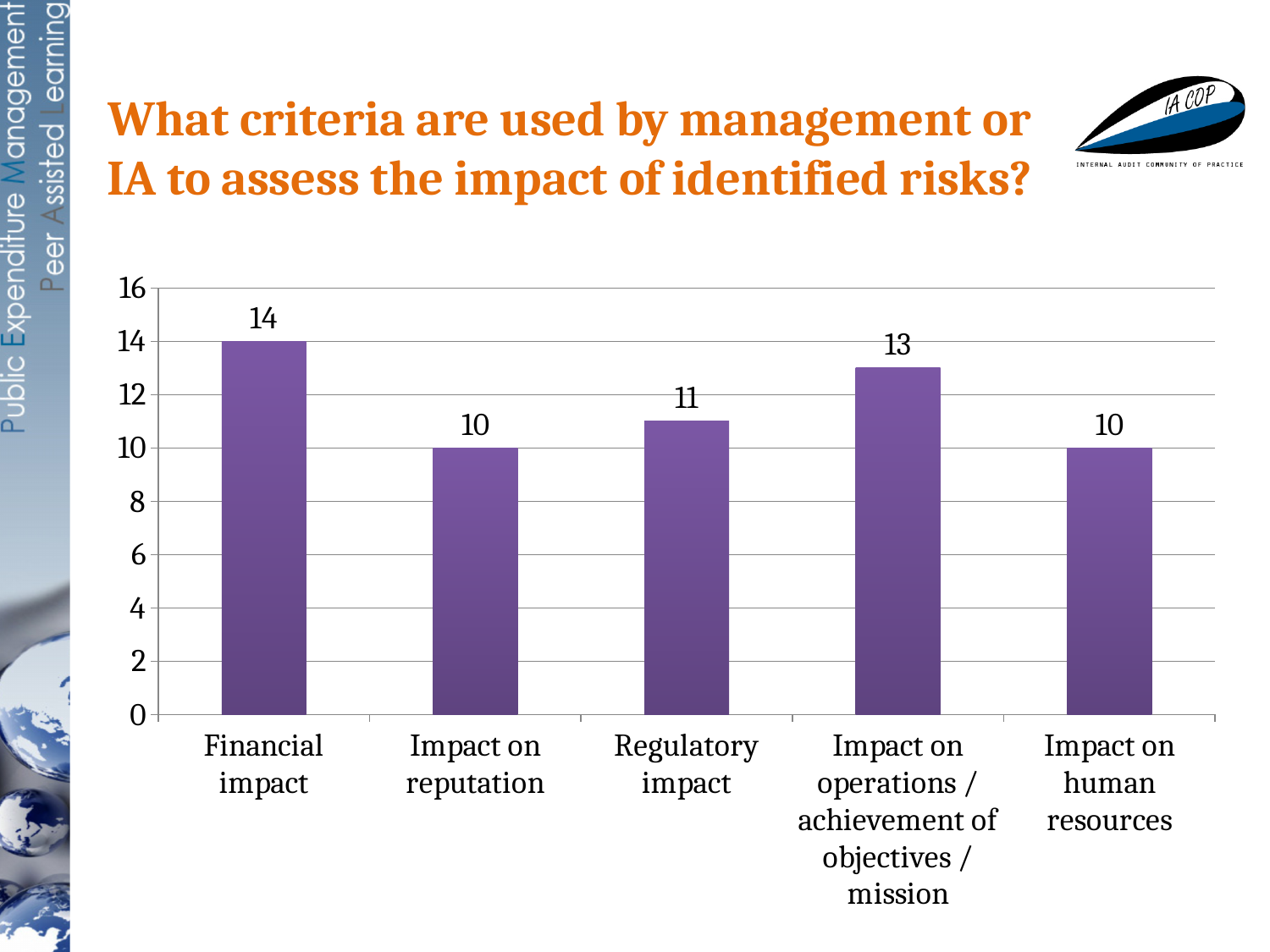
What is the title of the slide above the chart? What criteria are used by management or IA to assess the impact of identified risks? Is the value for Financial impact greater or less than 12? greater What is the value for Impact on human resources? 10 How many categories are shown on the x axis? 5 What is the difference between the values for Financial impact and Impact on reputation? 4 What is the difference between the values for Impact on operations / achievement of objectives / mission and Regulatory impact? 2 Which is larger, the value for Regulatory impact or the value for Impact on reputation? Regulatory impact What is the value for Regulatory impact? 11 Which category has the highest value? Financial impact What is the value for Financial impact? 14 What kind of chart is shown on the slide? bar chart What is the value for Impact on operations / achievement of objectives / mission? 13